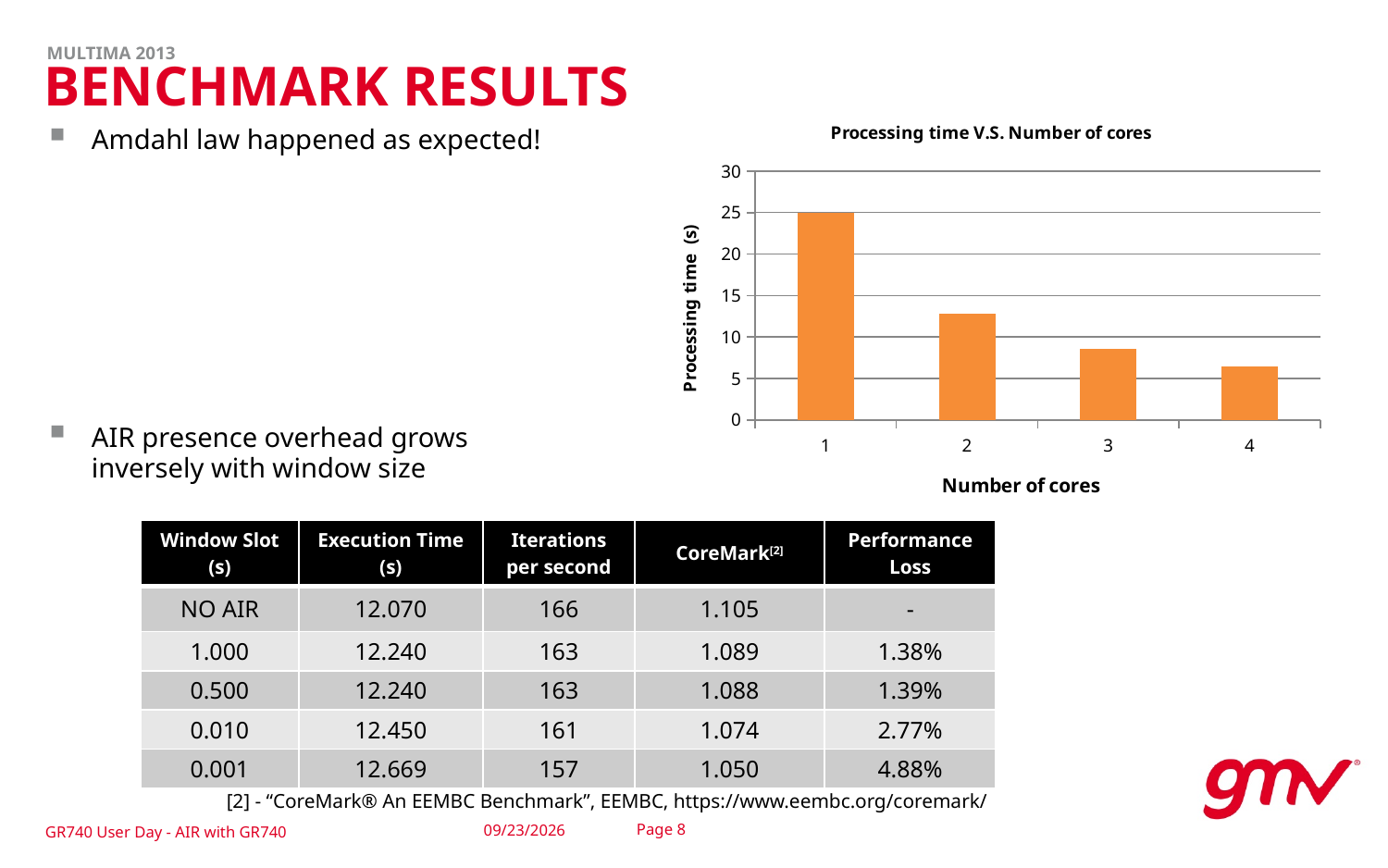
Does the processing time rise or fall as the number of cores increases? fall What is the title of the chart? Processing time V.S. Number of cores Is the processing time for 3 cores greater or less than 5? greater Is the processing time for 1 core greater or less than 20? greater What is the label of the vertical axis of the chart? Processing time (s) Is the processing time for 4 cores greater or less than 10? less Which number of cores has the highest processing time? 1 How many bars are plotted in the chart? 4 Which number of cores has the lowest processing time? 4 What kind of chart is shown on the slide? bar chart Which has a larger processing time, 2 cores or 3 cores? 2 cores